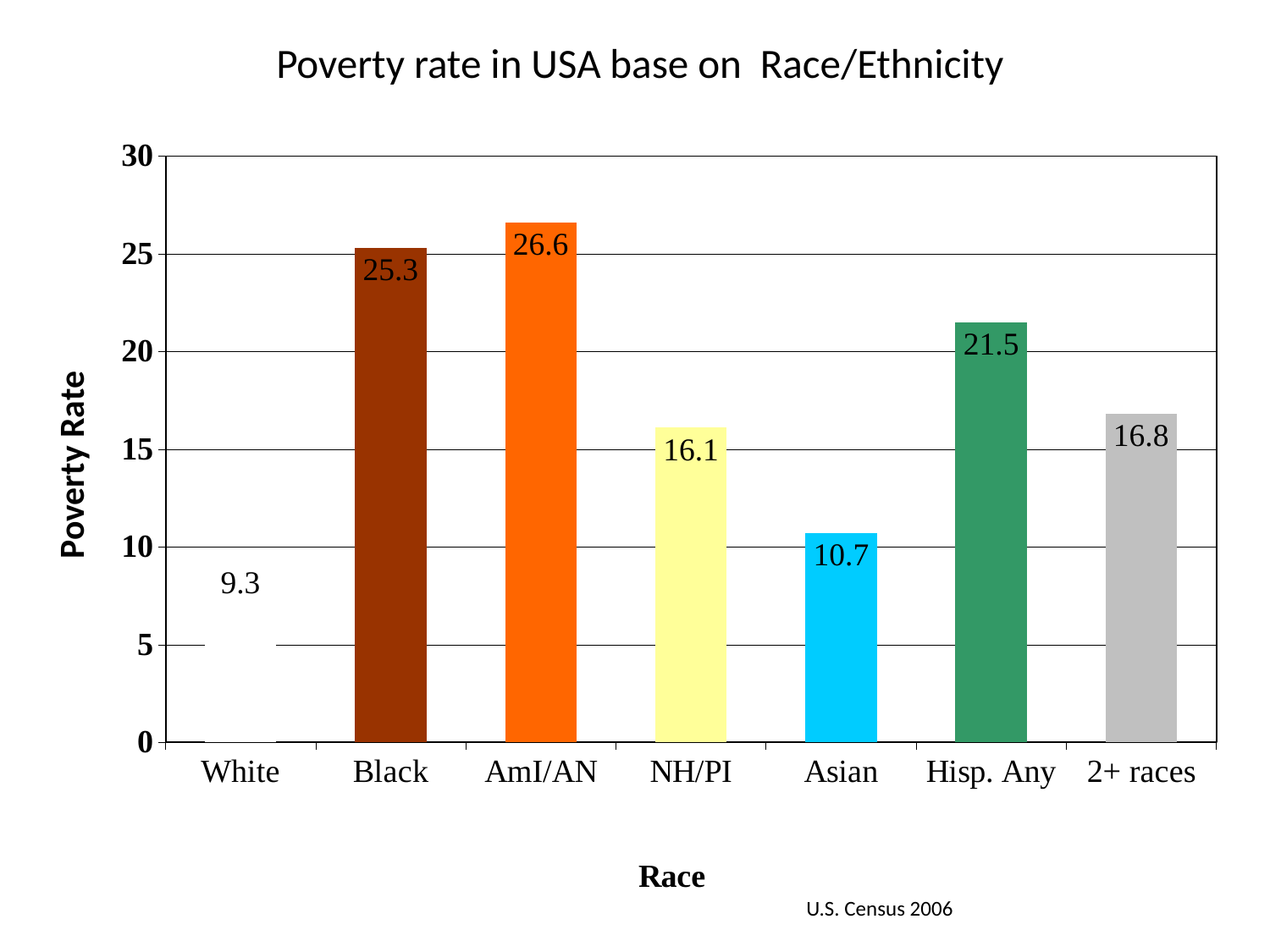
What is the poverty rate for 2+ races? 16.8 Which race/ethnicity has the lowest poverty rate? White What is the title of the chart? Poverty rate in USA base on Race/Ethnicity What is the poverty rate for Asian? 10.7 What is the poverty rate for Black? 25.3 What is the difference between the poverty rates for Hisp. Any and NH/PI? 5.4 Which has a higher poverty rate, NH/PI or 2+ races? 2+ races How many race/ethnicity categories are shown in the chart? 7 What is the difference between the poverty rates for AmI/AN and Black? 1.3 Is the poverty rate for Hisp. Any greater or less than 20? greater Which race/ethnicity has the highest poverty rate? AmI/AN What kind of chart is shown on the slide? bar chart